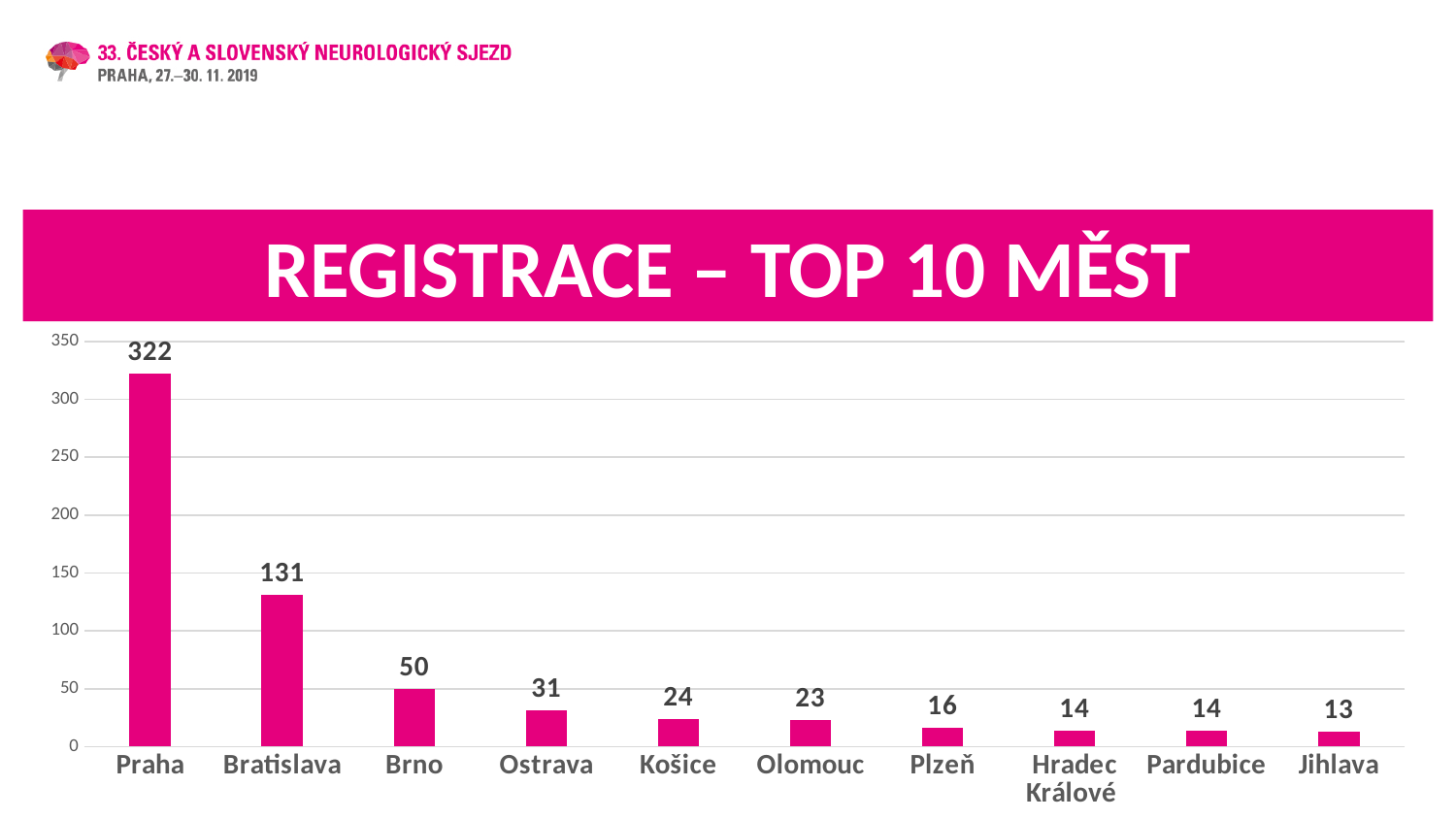
How many cities are shown in the chart? 10 Which city has the highest value? Praha What kind of chart is shown on the slide? bar chart Which is larger, the value for Olomouc or the value for Plzeň? Olomouc What is the value for Praha? 322 What is the difference between the values for Praha and Bratislava? 191 Which city has the lowest value? Jihlava What is the title of the chart? REGISTRACE – TOP 10 MĚST What is the value for Košice? 24 What is the value for Bratislava? 131 Is the value for Bratislava greater or less than 100? greater What is the difference between the values for Brno and Ostrava? 19